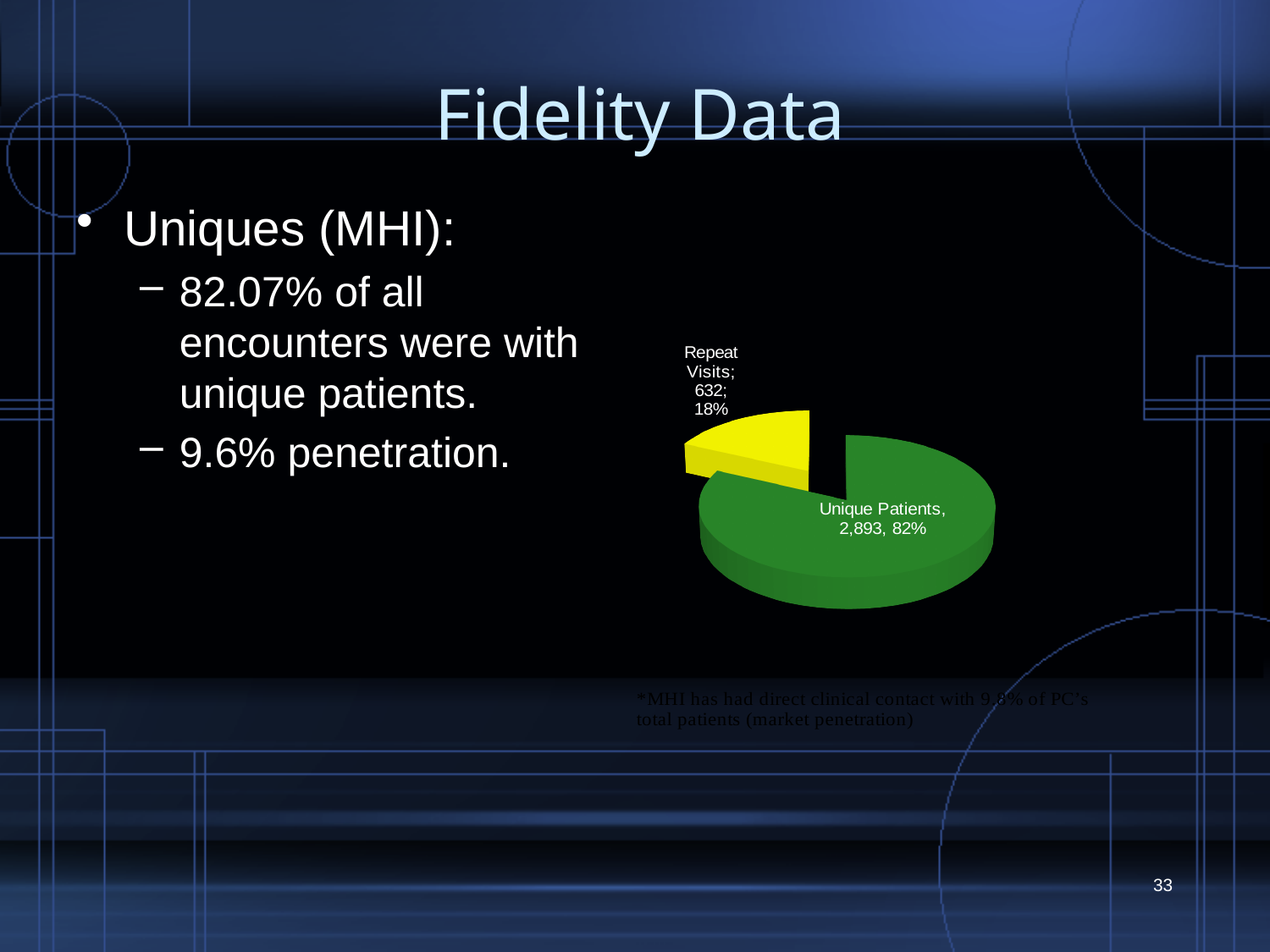
Which is larger, Unique Patients or Repeat Visits? Unique Patients What kind of chart is shown on the slide? pie chart What is the total of the two slices in the pie chart? 3,525 Which slice of the pie chart is the largest? Unique Patients What colour is the Repeat Visits slice in the pie chart? yellow What is the value for Unique Patients in the pie chart? 2,893 Which slice of the pie chart is the smallest? Repeat Visits How many slices does the pie chart have? 2 What is the difference between the Unique Patients value and the Repeat Visits value? 2,261 What is the value for Repeat Visits in the pie chart? 632 What share of the pie does Unique Patients represent? 82% What share of the pie does Repeat Visits represent? 18%